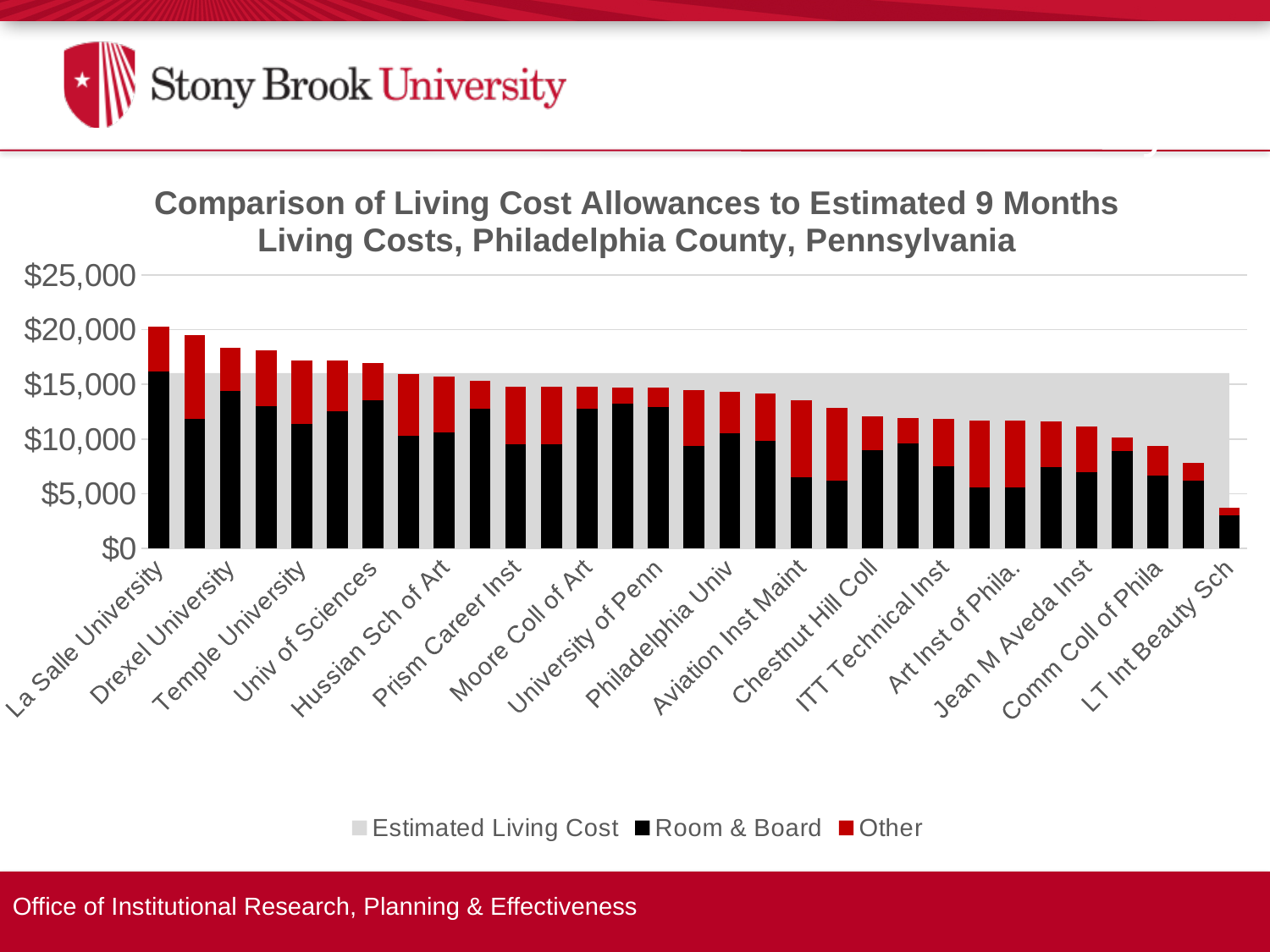
Is the total allowance for Drexel University greater or less than $20,000? less What kind of chart is shown on the slide? bar chart Do the total allowances rise or fall moving from left to right along the x axis? fall Which has a larger total allowance, Drexel University or Temple University? Drexel University How many series does the legend list? 3 Which institution has the highest total living cost allowance? La Salle University Is the total allowance for LT Int Beauty Sch greater or less than $5,000? less Is the total allowance for Aviation Inst Maint greater or less than $15,000? less Which series is shown in red in the legend? Other Which institution has the lowest total living cost allowance? LT Int Beauty Sch